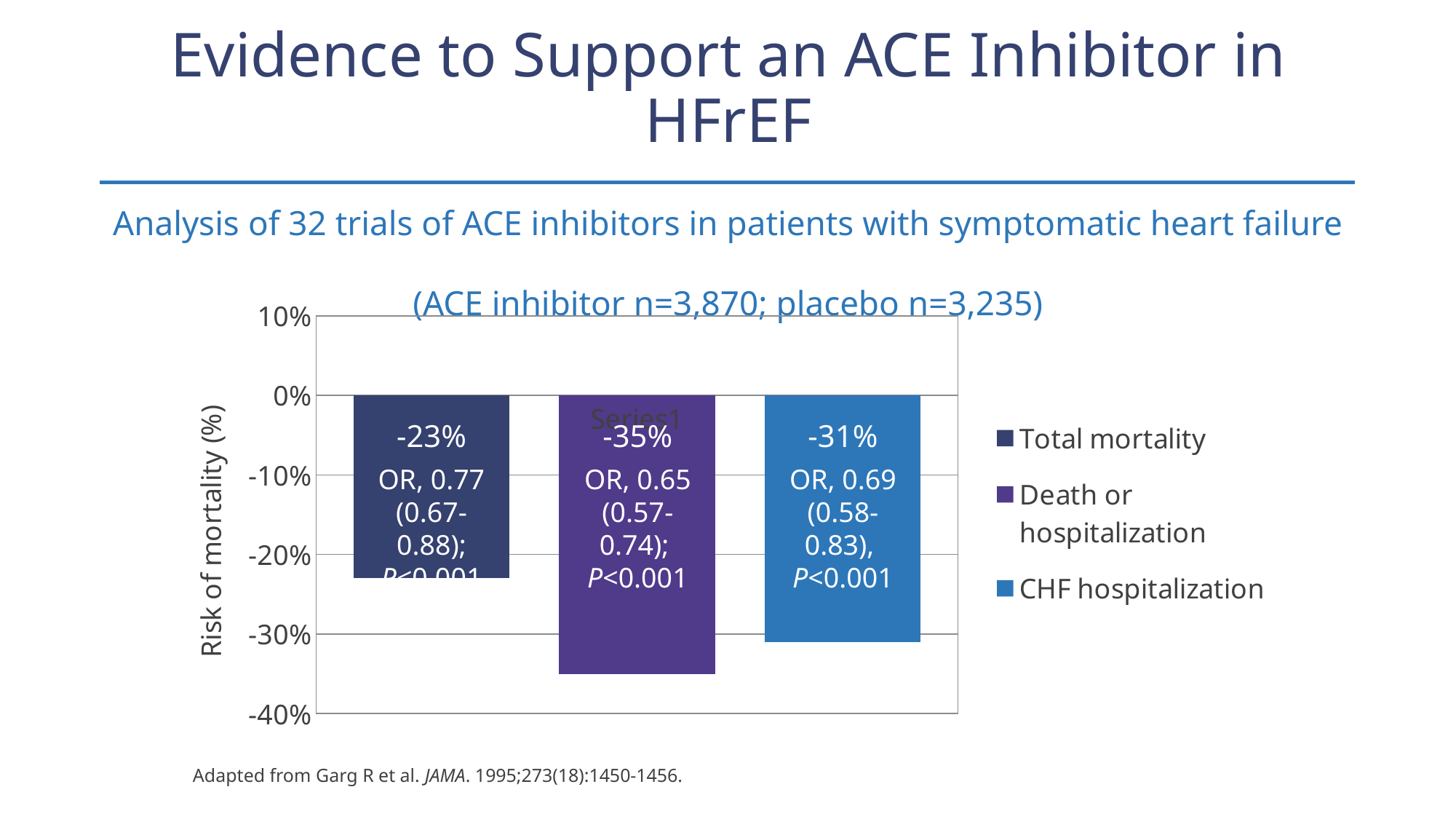
What kind of chart is shown on the slide? Bar chart What is the value shown for Total mortality? -23% Which series shows the smallest reduction in risk? Total mortality What colour is the Death or hospitalization bar? Purple Which bar extends further below zero: CHF hospitalization or Total mortality? CHF hospitalization What is the y-axis label of the chart? Risk of mortality (%) How many series does the legend list? 3 Which series shows the largest reduction in risk? Death or hospitalization What is the value shown for CHF hospitalization? -31% What is the difference between the Death or hospitalization value and the Total mortality value? 12 percentage points What is the value shown for Death or hospitalization? -35% What odds ratio is printed on the Total mortality bar? 0.77